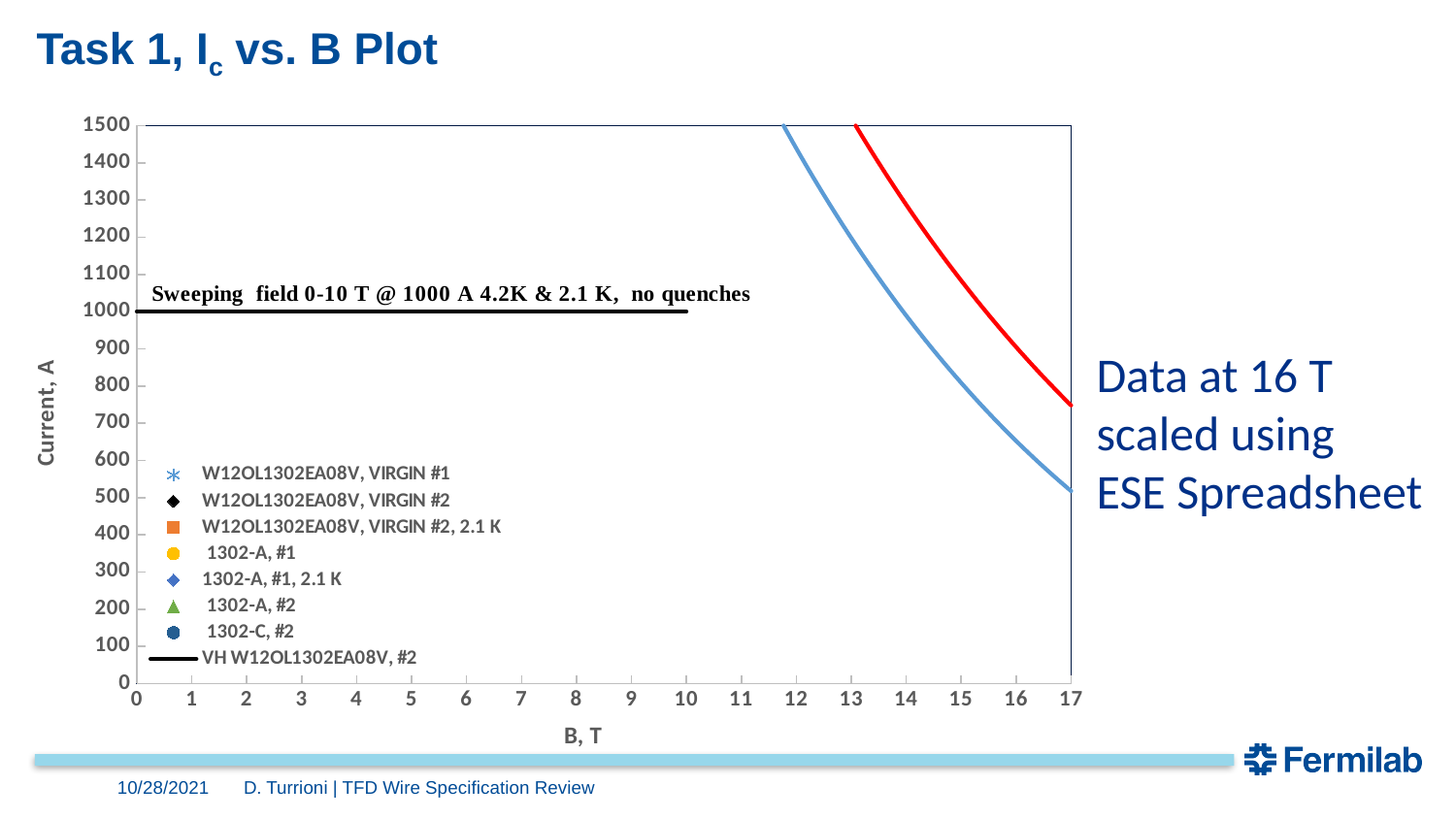
How many entries does the chart legend list? 8 Is the value of the red curve at 17 T greater or less than 800 A? less Is the value of the blue curve at 17 T greater or less than 600 A? less At what current is the horizontal black line for the sweeping field test drawn? 1000 A What is the label of the x axis? B, T Is the value of the red curve at 14 T greater or less than 1000 A? greater Do the plotted curves rise or fall as B increases from 12 T to 17 T? fall Which curve reaches 1500 A at a lower field, the red curve or the blue curve? blue curve At 17 T, which curve shows the higher current, the red curve or the blue curve? red curve What is the label of the y axis? Current, A What type of chart is shown on the slide? line chart